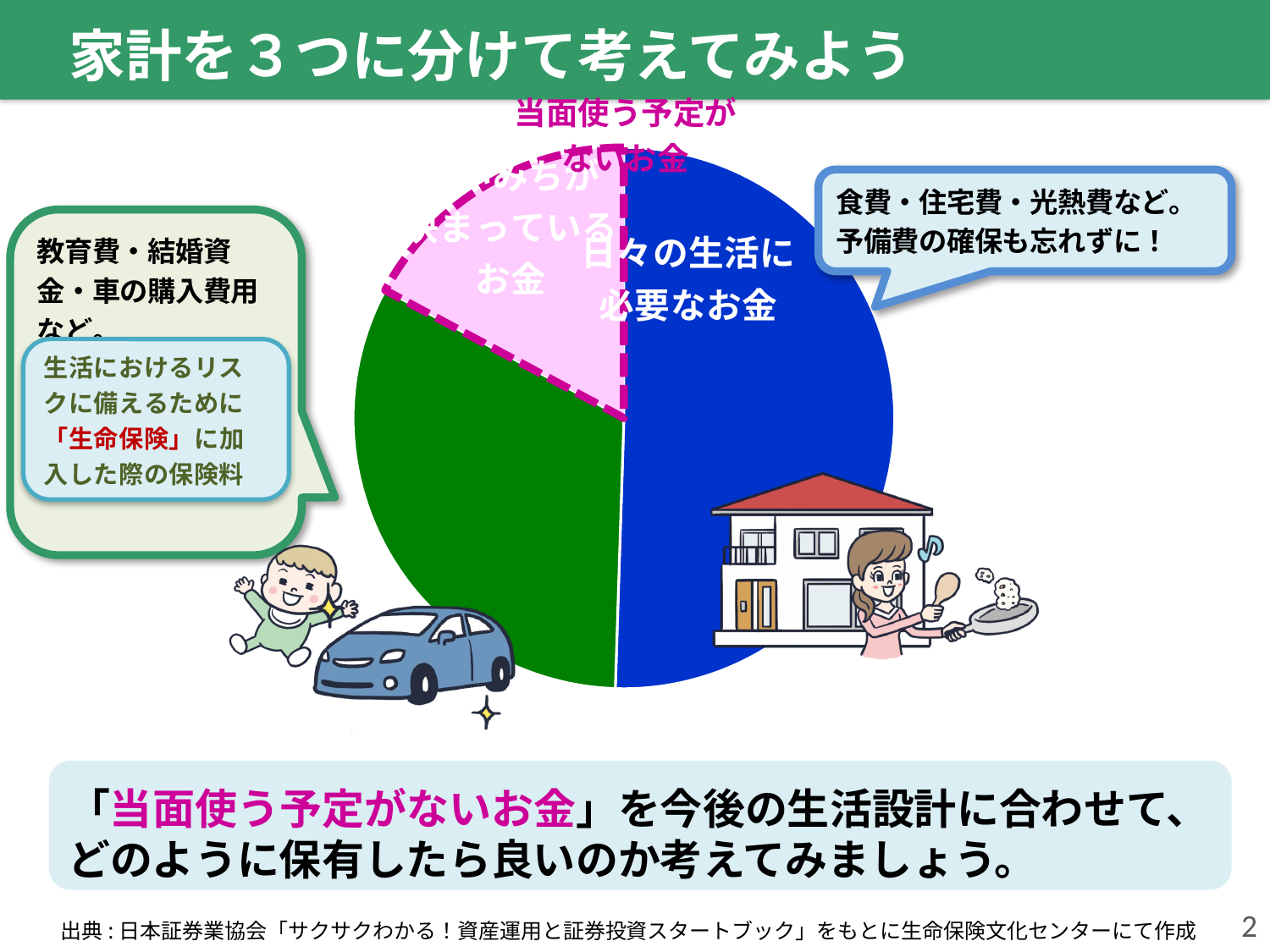
Which slice of the pie chart is the smallest? 当面使う予定がないお金 What kind of chart is shown on the slide? pie chart What colour is the slice labelled 日々の生活に必要なお金? blue How many slices does the pie chart have? 3 Which is larger in the pie chart: the green slice or the pink slice (当面使う予定がないお金)? the green slice Which is larger in the pie chart: the blue slice (日々の生活に必要なお金) or the green slice? 日々の生活に必要なお金 (blue) Which slice of the pie chart is the largest? 日々の生活に必要なお金 What colour is the slice labelled 当面使う予定がないお金? pink